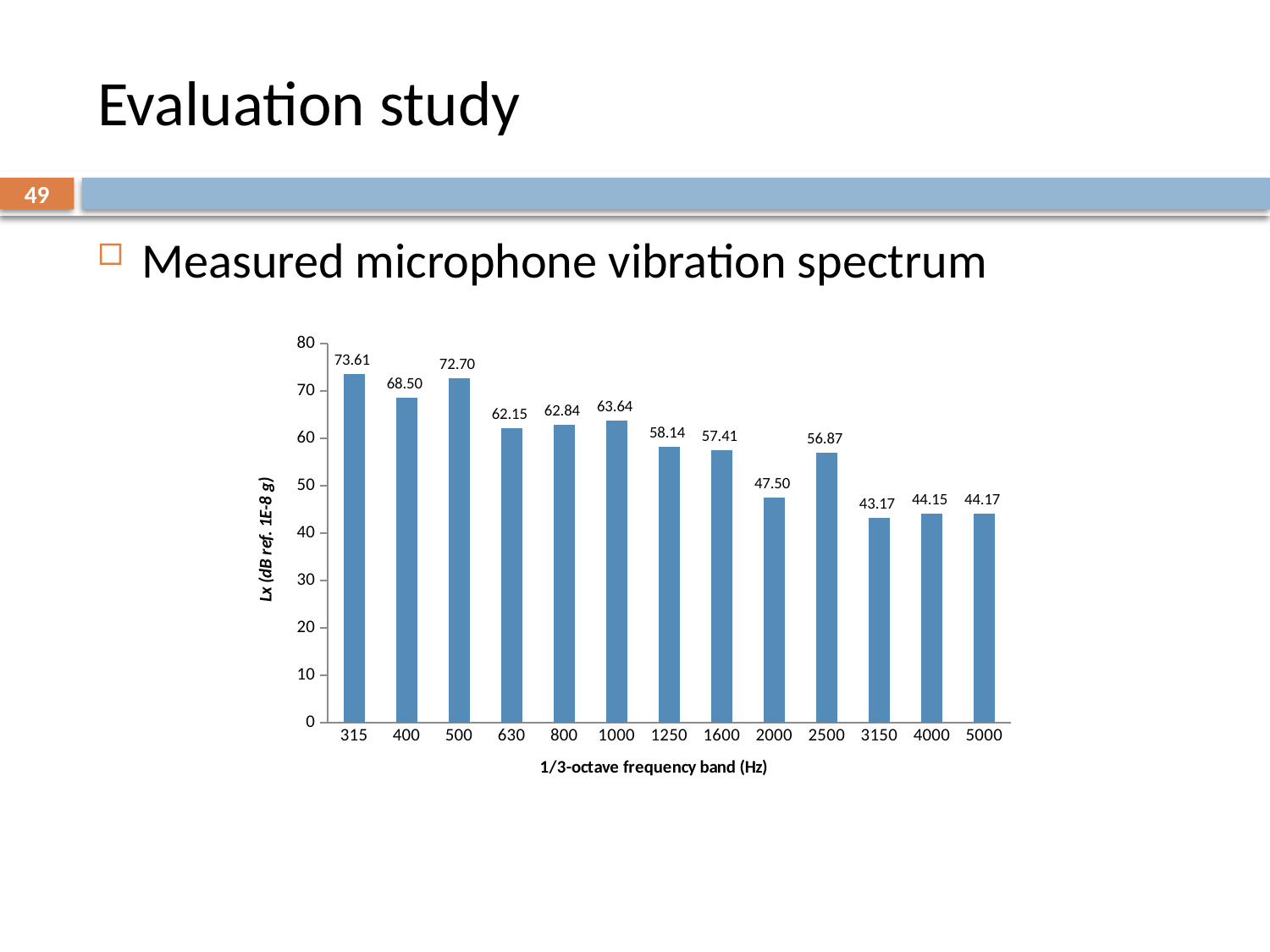
What is the value for the 2000 Hz band? 47.50 What is the value for the 5000 Hz band? 44.17 What is the value for the 315 Hz band? 73.61 Which frequency band has the highest value? 315 What is the difference between the values for the 315 Hz and 500 Hz bands? 0.91 Is the value for the 1250 Hz band greater or less than 50? greater Which is larger, the value for 1000 Hz or the value for 800 Hz? 1000 Hz What is the label of the x axis? 1/3-octave frequency band (Hz) What is the difference between the values for the 2500 Hz and 2000 Hz bands? 9.37 How many frequency bands are shown on the x axis? 13 What kind of chart is shown on the slide? bar chart Which frequency band has the lowest value? 3150